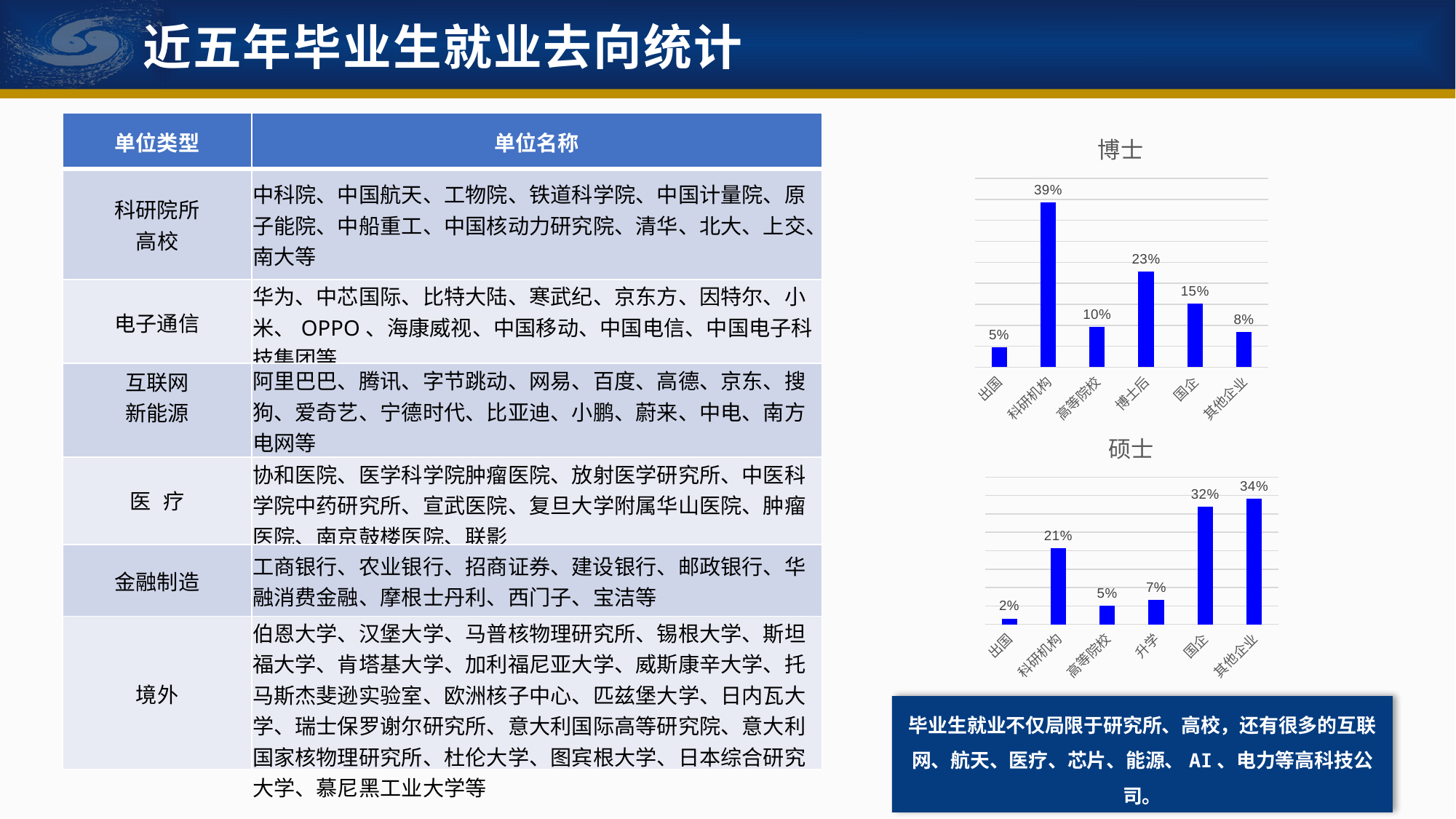
In the 博士 chart, what is the value for 博士后? 23% In the 硕士 chart, what is the difference between 其他企业 and 科研机构? 13% In the 博士 chart, which category has the lowest value? 出国 In the 硕士 chart, what is the value for 出国? 2% What type of chart is the 博士 chart? Bar chart In the 博士 chart, what is the difference between 科研机构 and 国企? 24% In the 硕士 chart, what is the value for 国企? 32% What is the title of the lower chart on the right side of the slide? 硕士 In the 硕士 chart, which category has the highest value? 其他企业 In the 硕士 chart, which is larger, 科研机构 or 升学? 科研机构 In the 博士 chart, what is the value for 科研机构? 39% In the 博士 chart, how many categories are shown? 6